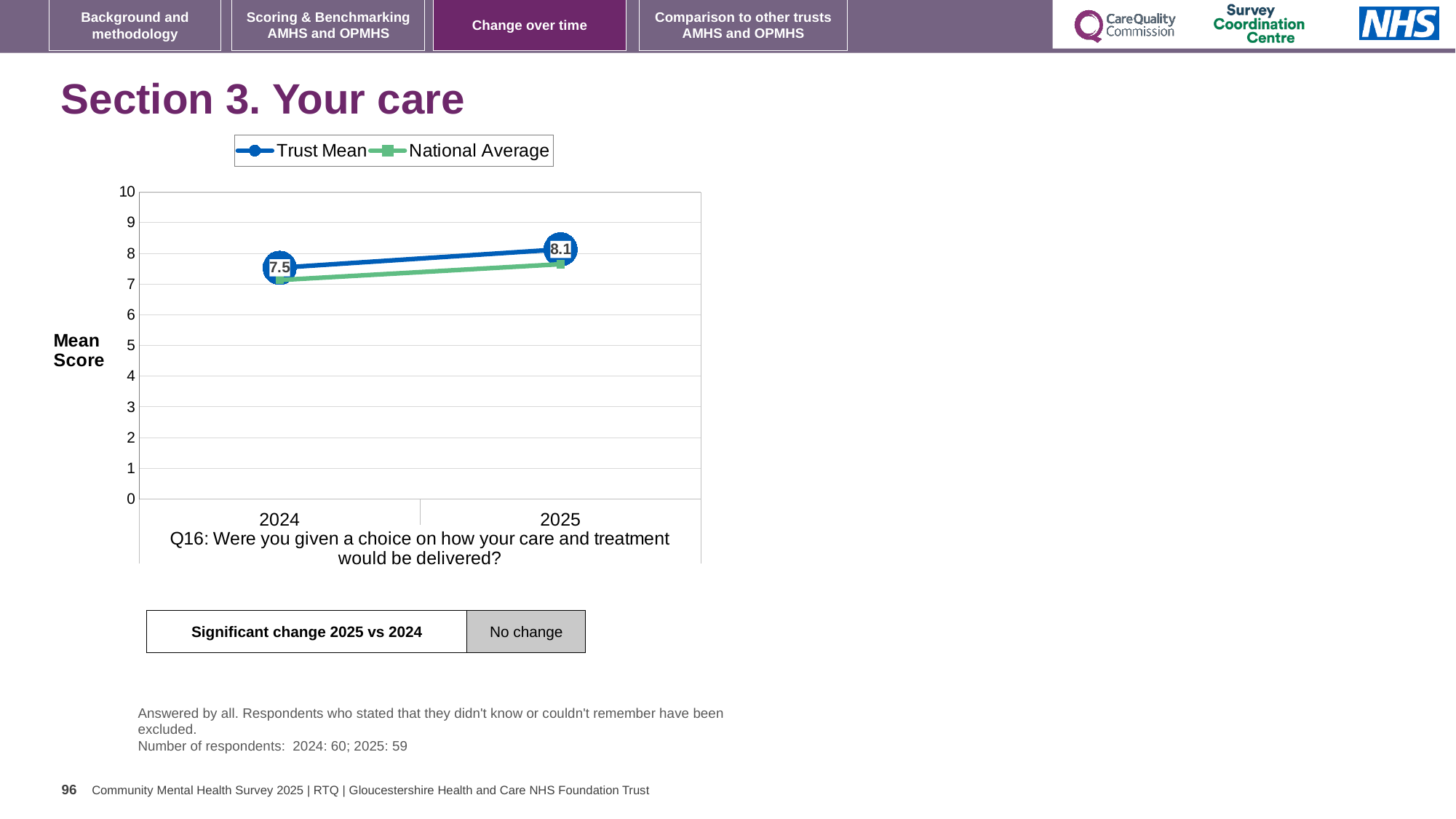
What kind of chart is shown on the slide? line chart Does the Trust Mean rise or fall from 2024 to 2025? rise Is the National Average for 2025 greater or less than 5? greater By how much did the Trust Mean change from 2024 to 2025? 0.6 Is the National Average for 2024 greater or less than 8? less How many years are plotted on the x axis? 2 How many series does the legend list? 2 What is the label on the y axis of the chart? Mean Score What is the Trust Mean score for 2025? 8.1 In which year is the Trust Mean highest? 2025 In 2025, which is larger: the Trust Mean or the National Average? Trust Mean What is the Trust Mean score for 2024? 7.5